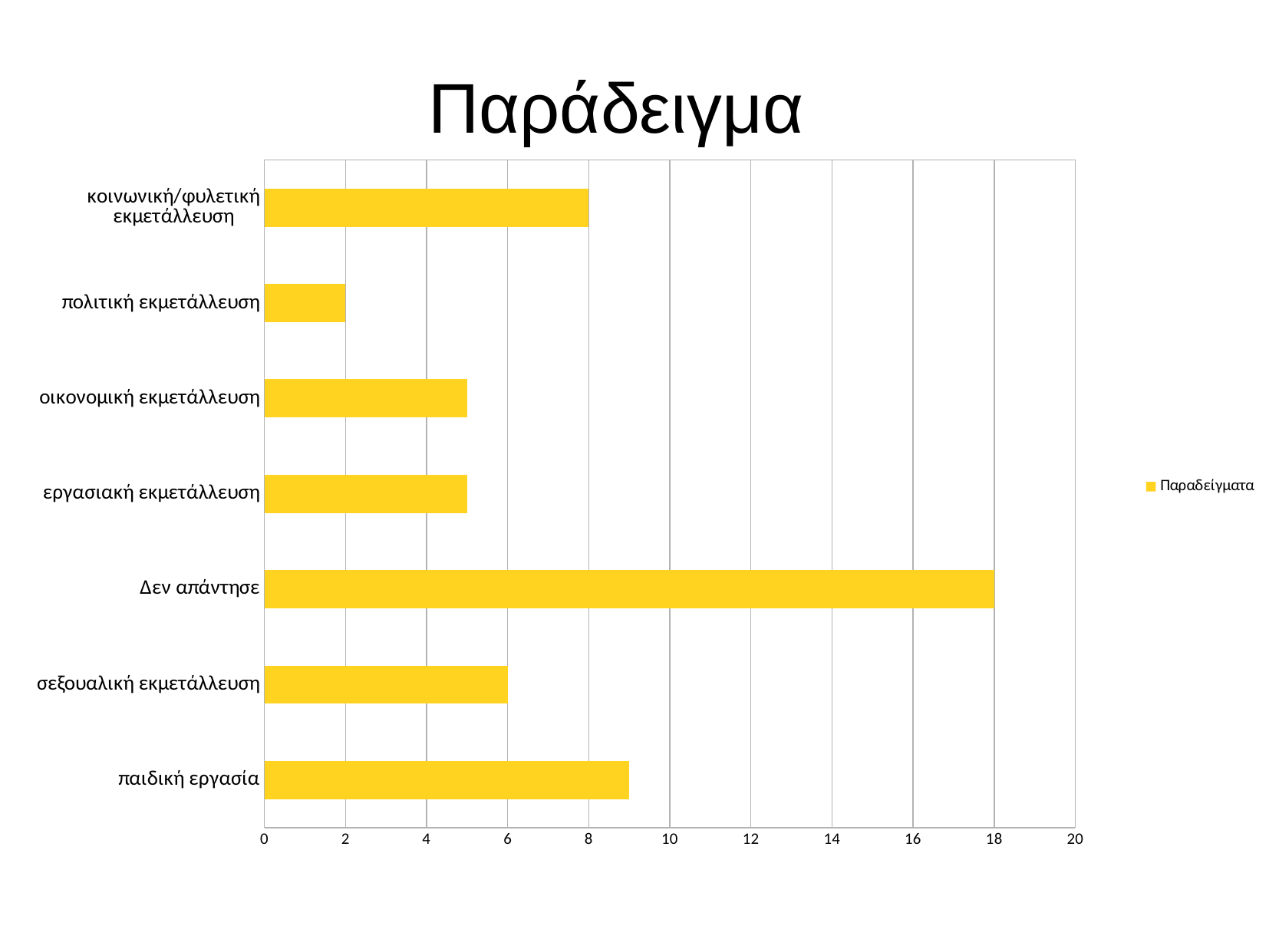
What type of chart is shown on the slide? Bar chart What is the value for Δεν απάντησε? 18 Which category has the highest value? Δεν απάντησε What is the difference between the values for Δεν απάντησε and πολιτική εκμετάλλευση? 16 How many categories are shown in the chart? 7 Which is larger, the value for παιδική εργασία or the value for σεξουαλική εκμετάλλευση? παιδική εργασία Which category has the lowest value? πολιτική εκμετάλλευση What is the value for πολιτική εκμετάλλευση? 2 Is the value for οικονομική εκμετάλλευση greater or less than 4? greater What is the value for κοινωνική/φυλετική εκμετάλλευση? 8 What is the legend entry shown for the series? Παραδείγματα What is the value for σεξουαλική εκμετάλλευση? 6